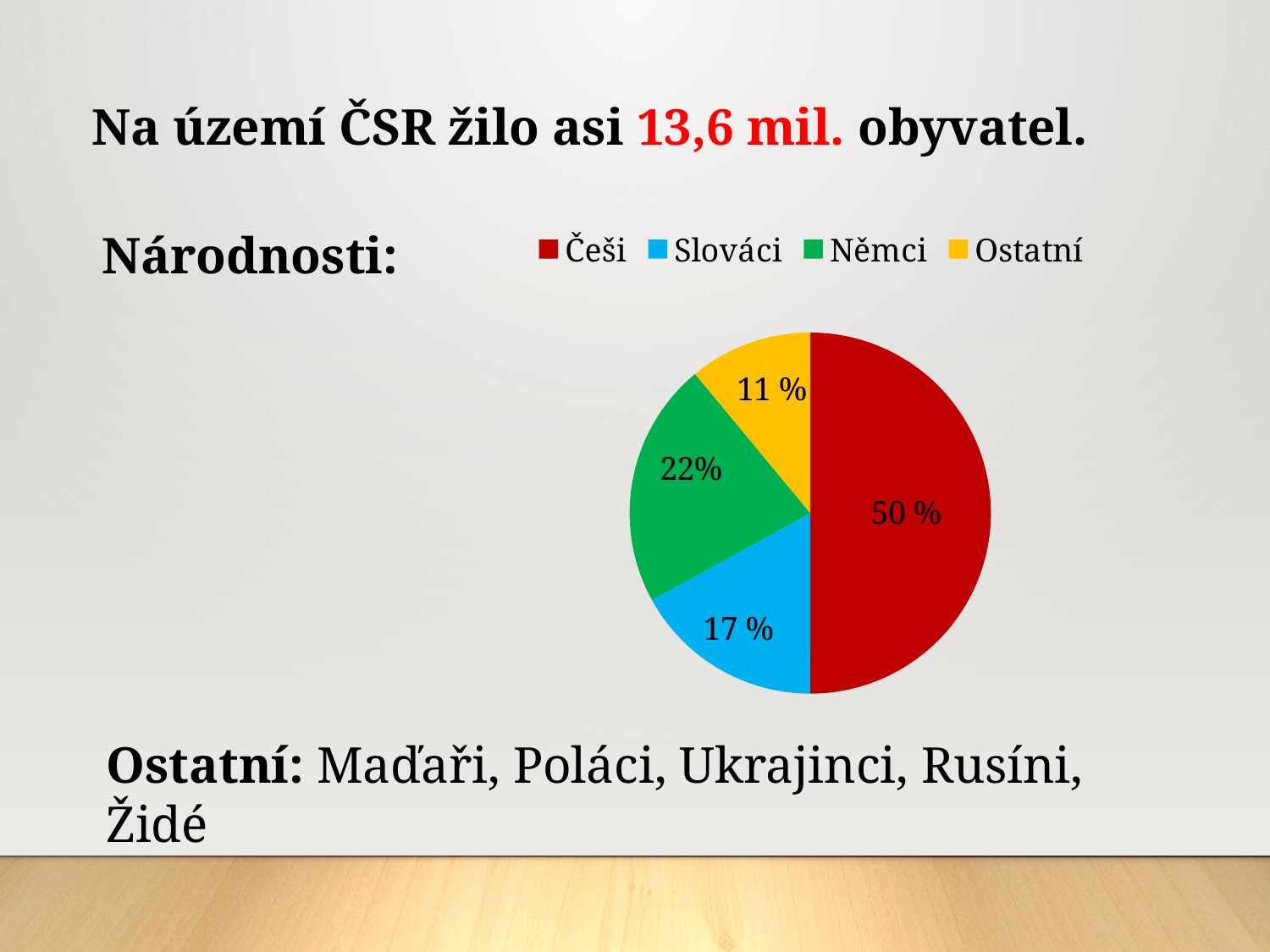
What colour is the Slováci slice in the pie chart? Blue What share of the pie does Ostatní have? 11 % How many slices does the pie chart have? 4 What kind of chart is shown on the slide? Pie chart What share of the pie does Slováci have? 17 % Which slice is larger, Němci or Slováci? Němci What is the difference in percentage points between the Češi slice and the Němci slice? 28 What share of the pie does Němci have? 22% Which nationality has the smallest slice of the pie? Ostatní What is the difference in percentage points between the Slováci slice and the Ostatní slice? 6 Which nationality has the largest slice of the pie? Češi What share of the pie does Češi have? 50 %